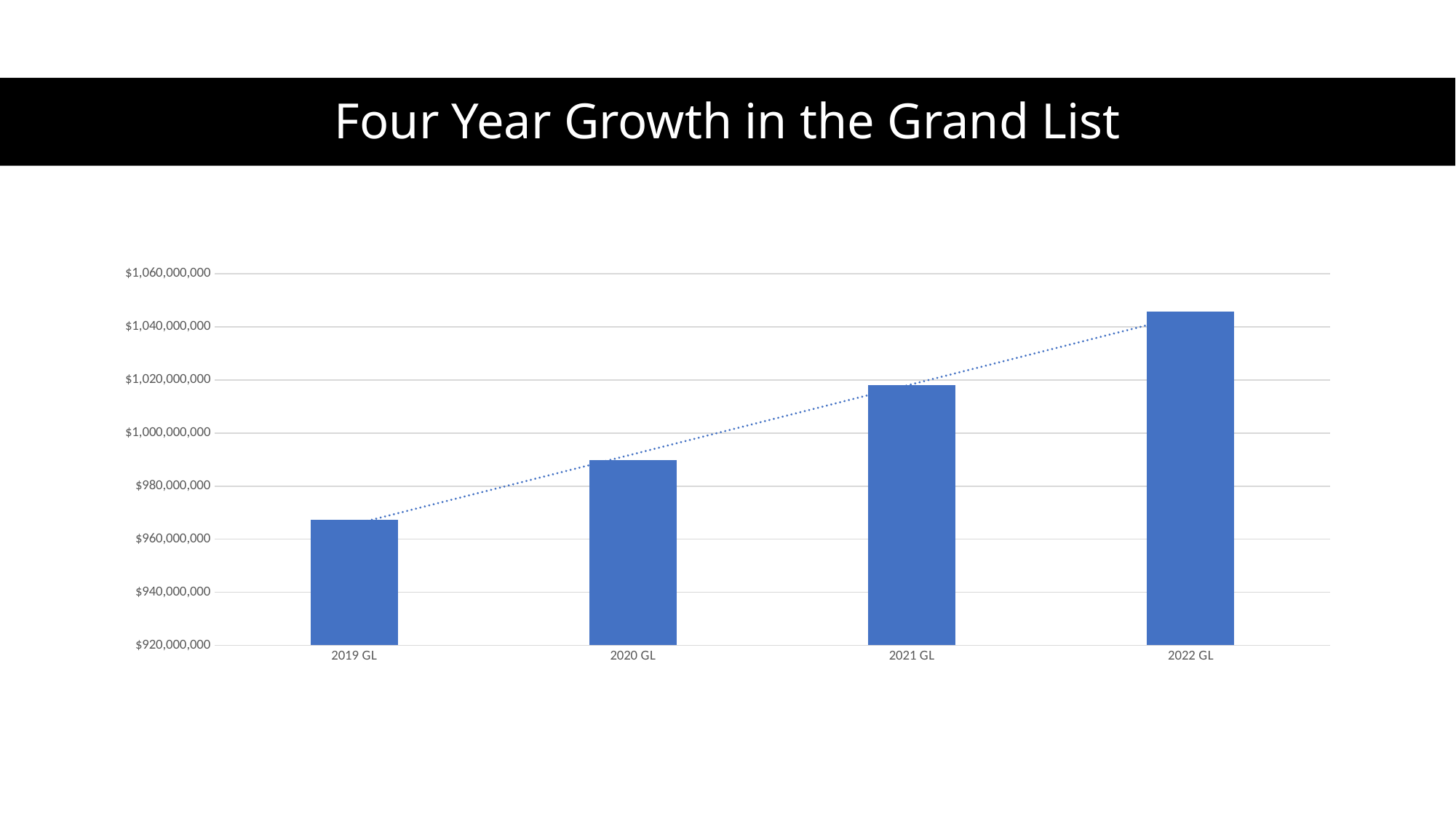
Is the value for 2019 GL greater or less than $980,000,000? less Which category has the lowest value? 2019 GL What is the lowest value shown on the vertical axis? $920,000,000 How many bars (categories) are plotted in the chart? 4 Is the value for 2022 GL greater or less than $1,040,000,000? greater What kind of chart is shown on the slide? bar chart Is the value for 2021 GL greater or less than $1,000,000,000? greater What is the title of the slide? Four Year Growth in the Grand List Which is larger, the value for 2020 GL or the value for 2021 GL? 2021 GL Which category has the highest value? 2022 GL Do the values rise or fall from 2019 GL to 2022 GL? rise